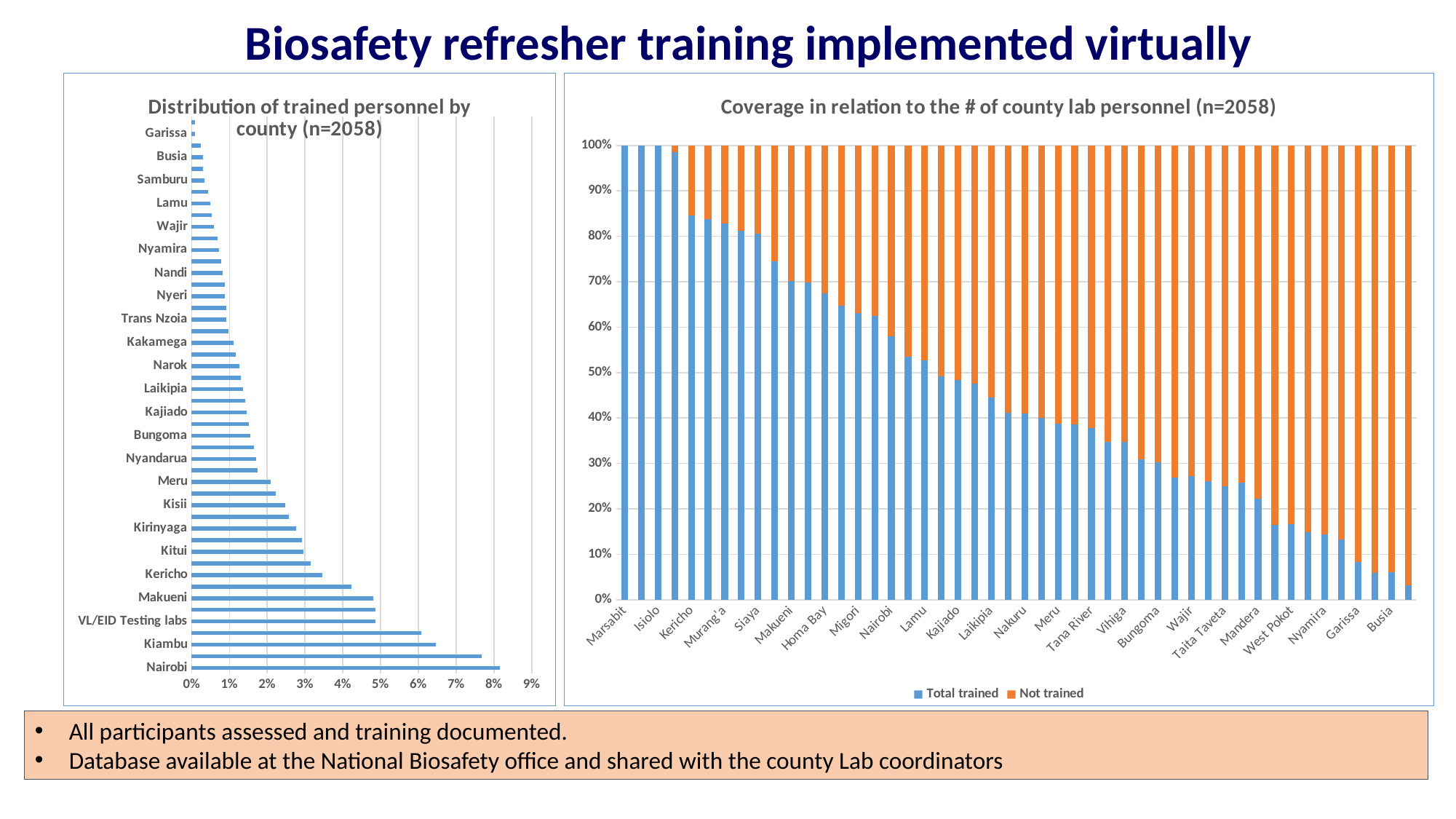
In the left chart, 'Distribution of trained personnel by county', is the value for Nairobi greater or less than 7%? greater In the left chart, 'Distribution of trained personnel by county', is the value for Kiambu greater or less than 5%? greater In the right chart, 'Coverage in relation to the # of county lab personnel', is the Total trained value for Busia greater or less than 10%? less In the left chart, 'Distribution of trained personnel by county', which has the larger value, Kitui or Meru? Kitui In the right chart, 'Coverage in relation to the # of county lab personnel', does the Total trained share rise or fall moving from left to right along the x axis? Fall In the right chart, 'Coverage in relation to the # of county lab personnel', what is the Total trained value for Marsabit? 100% In the left chart, 'Distribution of trained personnel by county', which county has the highest share of trained personnel? Nairobi What type of chart is the left chart, 'Distribution of trained personnel by county (n=2058)'? Bar chart In the left chart, 'Distribution of trained personnel by county', which labelled county has the lowest share of trained personnel? Garissa How many series does the legend of the right chart, 'Coverage in relation to the # of county lab personnel', list? 2